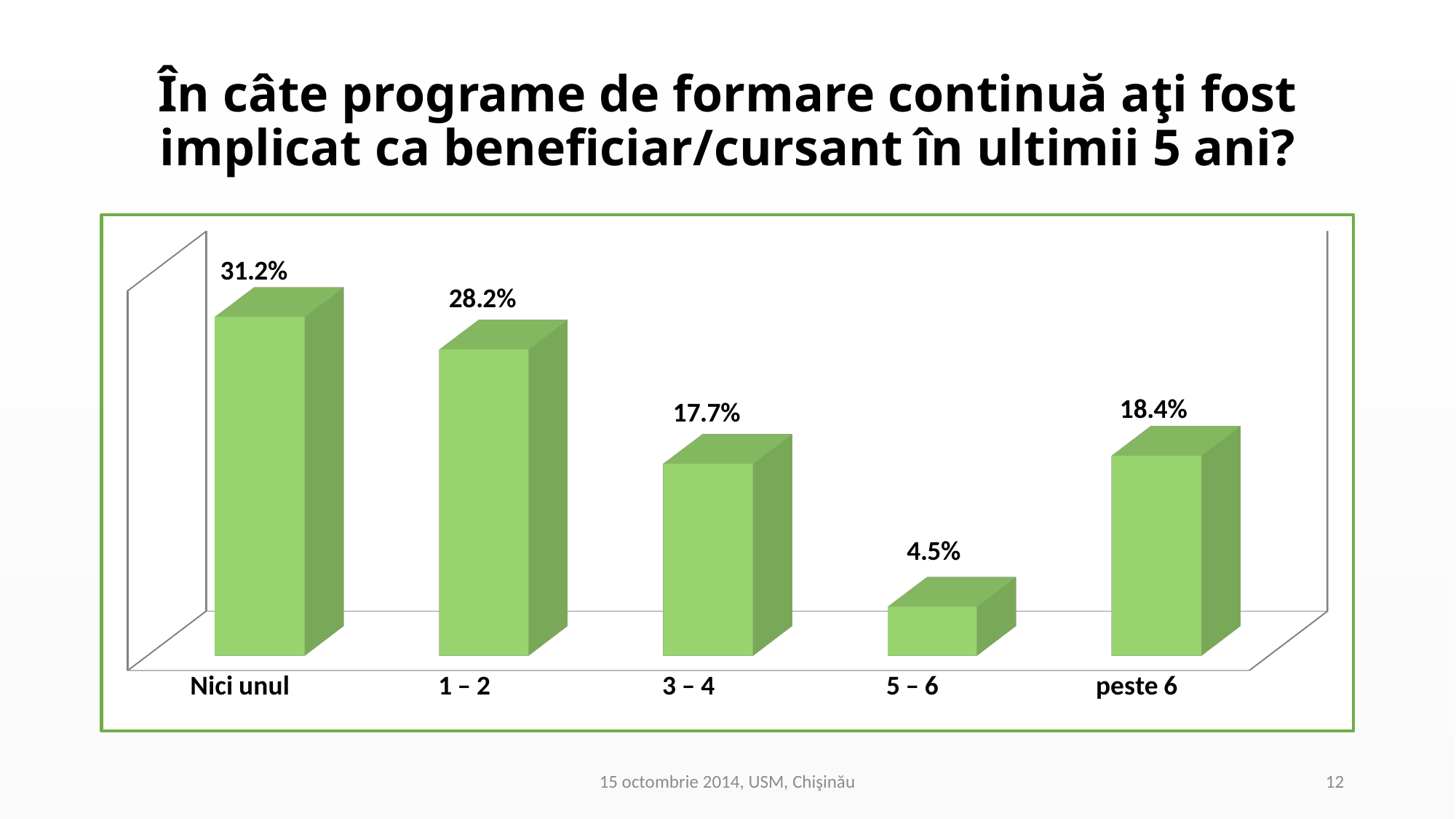
Which is larger, the value for '3 – 4' or the value for 'peste 6'? peste 6 How many categories are shown on the x axis? 5 What kind of chart is shown on the slide? Bar chart What is the value for '1 – 2'? 28.2% What is the difference between the values for 'peste 6' and '5 – 6'? 13.9% What is the value for '3 – 4'? 17.7% What is the value for '5 – 6'? 4.5% What is the difference between the values for 'Nici unul' and '1 – 2'? 3.0% What is the value for 'peste 6'? 18.4% What is the value for 'Nici unul'? 31.2% Which category has the highest value? Nici unul Which category has the lowest value? 5 – 6